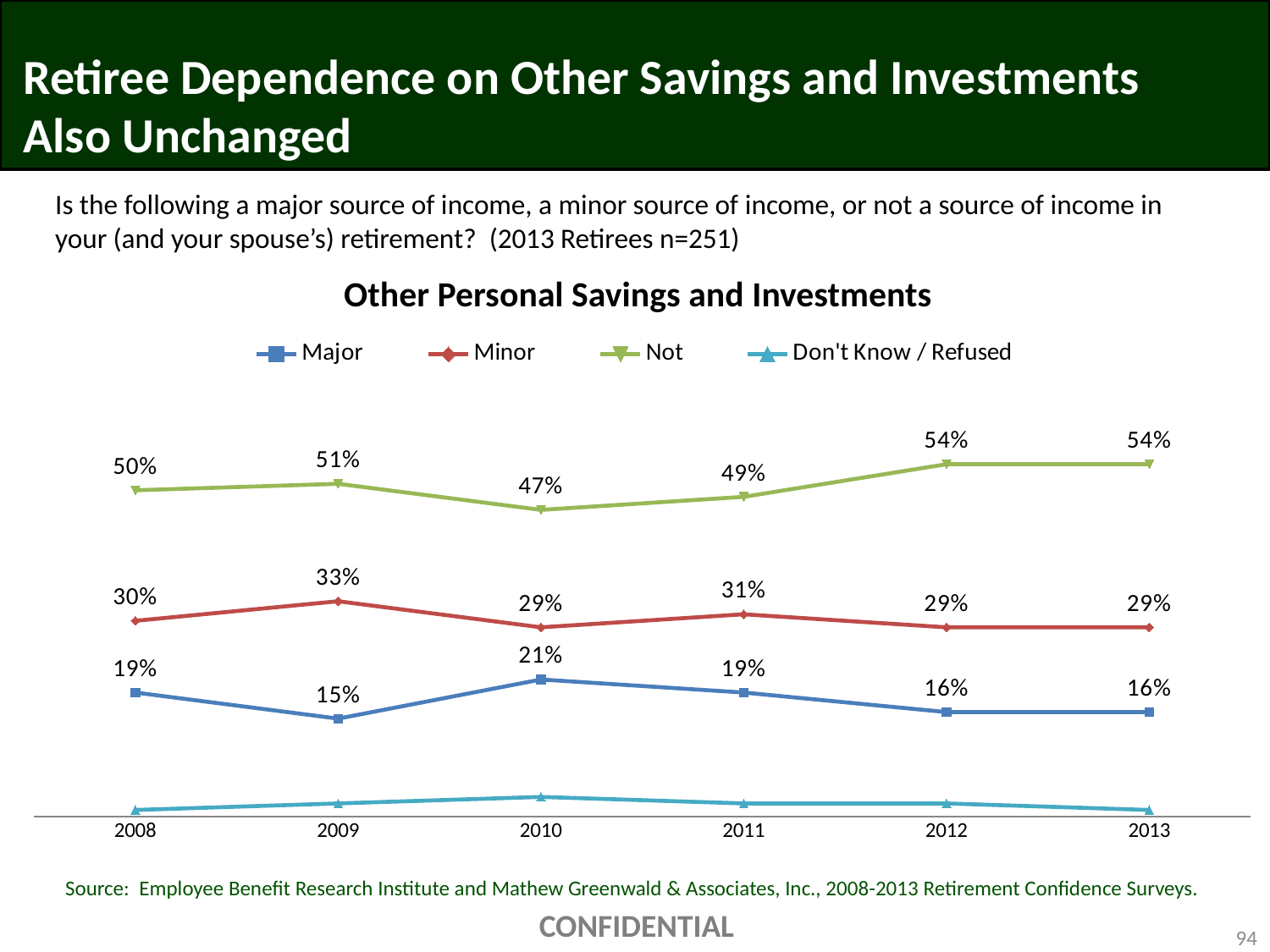
What is the value for the Minor series in 2009? 33% What is the title of the chart? Other Personal Savings and Investments What is the value for the Major series in 2010? 21% How many years are shown on the x axis? 6 How many series does the legend list? 4 What kind of chart is shown? Line chart What is the difference between the Not value and the Minor value in 2012? 25% Which is larger in 2011, the Minor value or the Major value? Minor What is the value for the Not series in 2013? 54% In which year is the Major series lowest? 2009 Does the Not series rise or fall from 2011 to 2012? Rise In which year is the Not series lowest? 2010